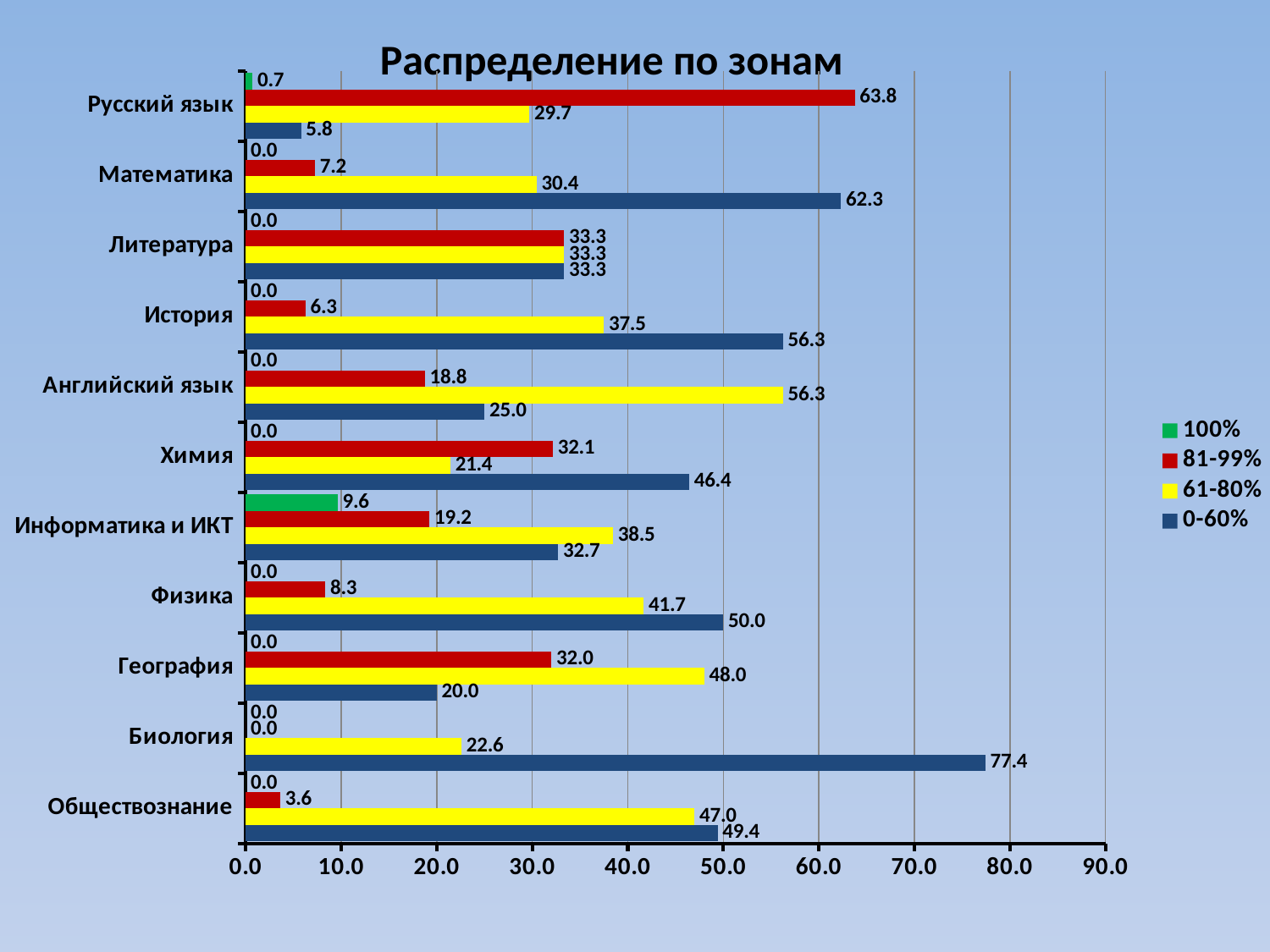
Is the 61-80% value for География greater or less than 40.0? greater Which subject has the highest value in the 0-60% series? Биология How many subjects are shown on the chart? 11 Which is larger for Английский язык: the 61-80% value or the 0-60% value? 61-80% What is the value of the 81-99% series for Русский язык? 63.8 What is the value of the 0-60% series for Биология? 77.4 What is the difference between the 0-60% value for Математика and the 0-60% value for Русский язык? 56.5 How many series does the legend list? 4 What is the value of the 100% series for Информатика и ИКТ? 9.6 What is the title of the chart? Распределение по зонам Which subject has the lowest value in the 0-60% series? Русский язык What kind of chart is shown on the slide? bar chart